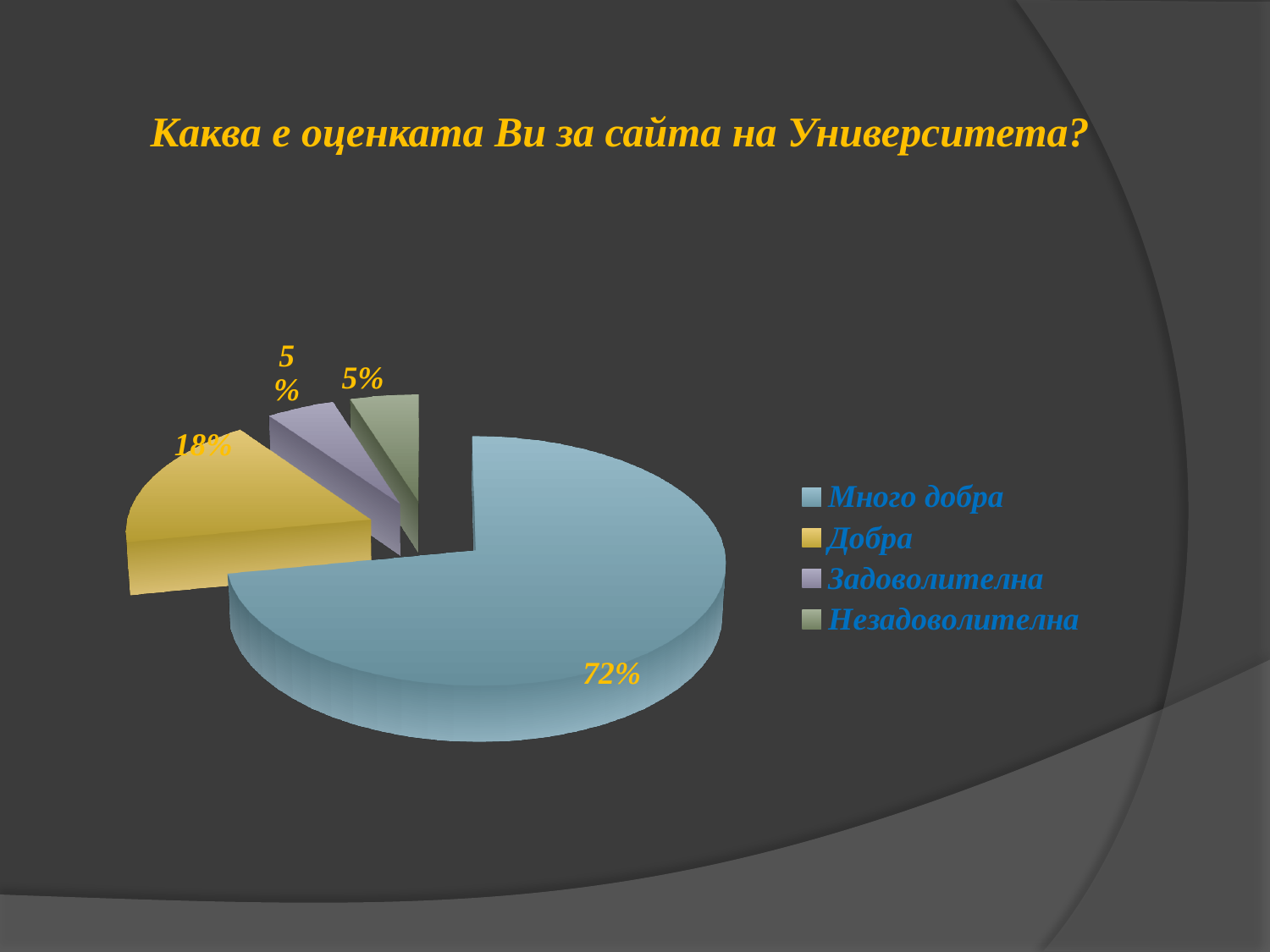
Which is larger, the slice for Добра or the slice for Задоволителна? Добра What share of the pie does Незадоволителна have? 5% What is the difference in percentage points between Много добра and Добра? 54 Which category has the largest slice of the pie? Много добра What type of chart is shown on the slide? pie chart What share of the pie does Задоволителна have? 5% What is the combined share of Задоволителна and Незадоволителна? 10% What colour is the slice for Добра? yellow What share of the pie does Добра have? 18% What is the title of the chart? Каква е оценката Ви за сайта на Университета? How many categories does the legend list? 4 What share of the pie does Много добра have? 72%